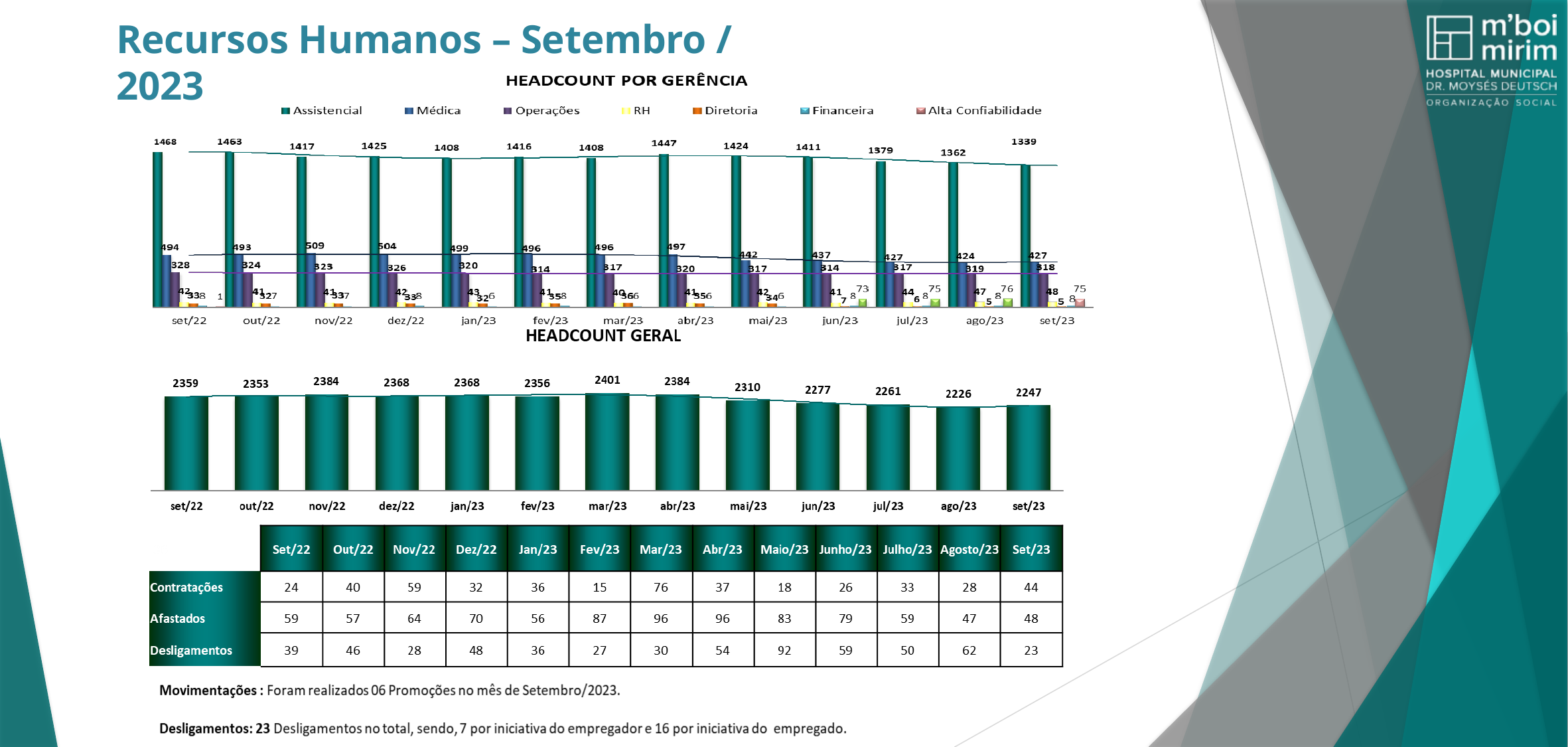
In the HEADCOUNT GERAL chart, how many months are shown on the x axis? 13 In the HEADCOUNT POR GERÊNCIA chart, how many series does the legend list? 7 In the HEADCOUNT POR GERÊNCIA chart, is the Médica value for abr/23 larger or smaller than the Médica value for mai/23? larger In the HEADCOUNT POR GERÊNCIA chart, what is the difference between the Assistencial values for abr/23 and mai/23? 23 In the HEADCOUNT GERAL chart, which month has the lowest value? ago/23 In the HEADCOUNT GERAL chart, what is the difference between the values for set/22 and set/23? 112 In the HEADCOUNT GERAL chart, which month has the highest value? mar/23 What kind of chart is the HEADCOUNT GERAL chart? bar chart In the HEADCOUNT POR GERÊNCIA chart, which month has the highest Assistencial value? set/22 In the HEADCOUNT GERAL chart, what is the value for mar/23? 2401 In the HEADCOUNT POR GERÊNCIA chart, what is the Assistencial value for set/23? 1339 In the HEADCOUNT POR GERÊNCIA chart, what is the Médica value for nov/22? 509